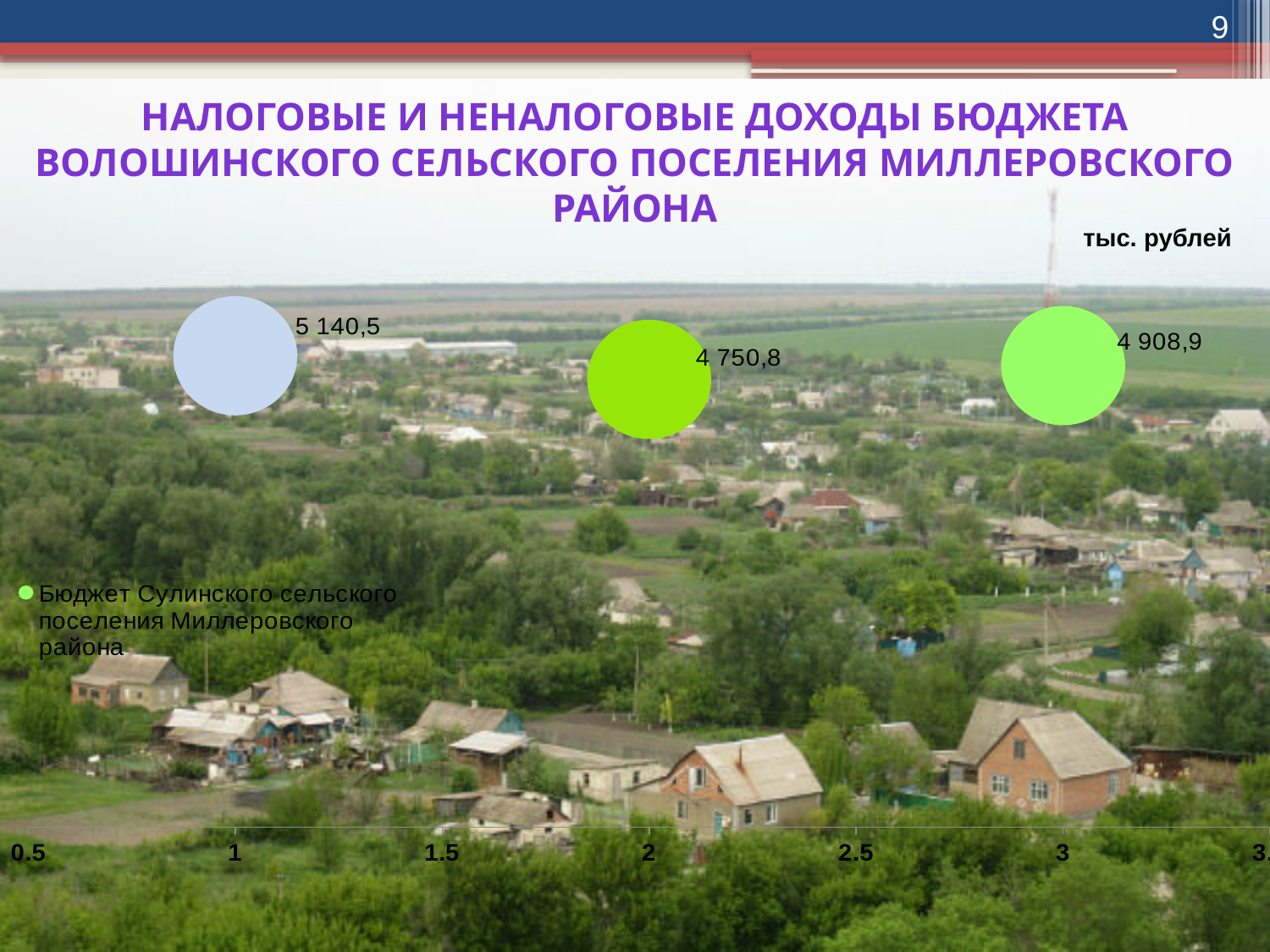
Which bubble has the highest labelled value? the leftmost bubble (5 140,5) What value is labelled on the middle bubble? 4 750,8 What kind of chart is shown on the slide? bubble chart Which is larger: the value of the middle bubble or the value of the rightmost bubble? the rightmost bubble (4 908,9) How many bubbles (data points) are plotted on the chart? 3 What is the difference between the leftmost bubble's value (5 140,5) and the rightmost bubble's value (4 908,9)? 231,6 Which bubble has the lowest labelled value? the middle bubble (4 750,8) What value is labelled on the rightmost bubble? 4 908,9 Does the value fall or rise from the leftmost bubble to the middle bubble? falls What value is labelled on the leftmost bubble? 5 140,5 How many series does the legend list? 1 In what units are the chart values given, according to the label above the chart? тыс. рублей